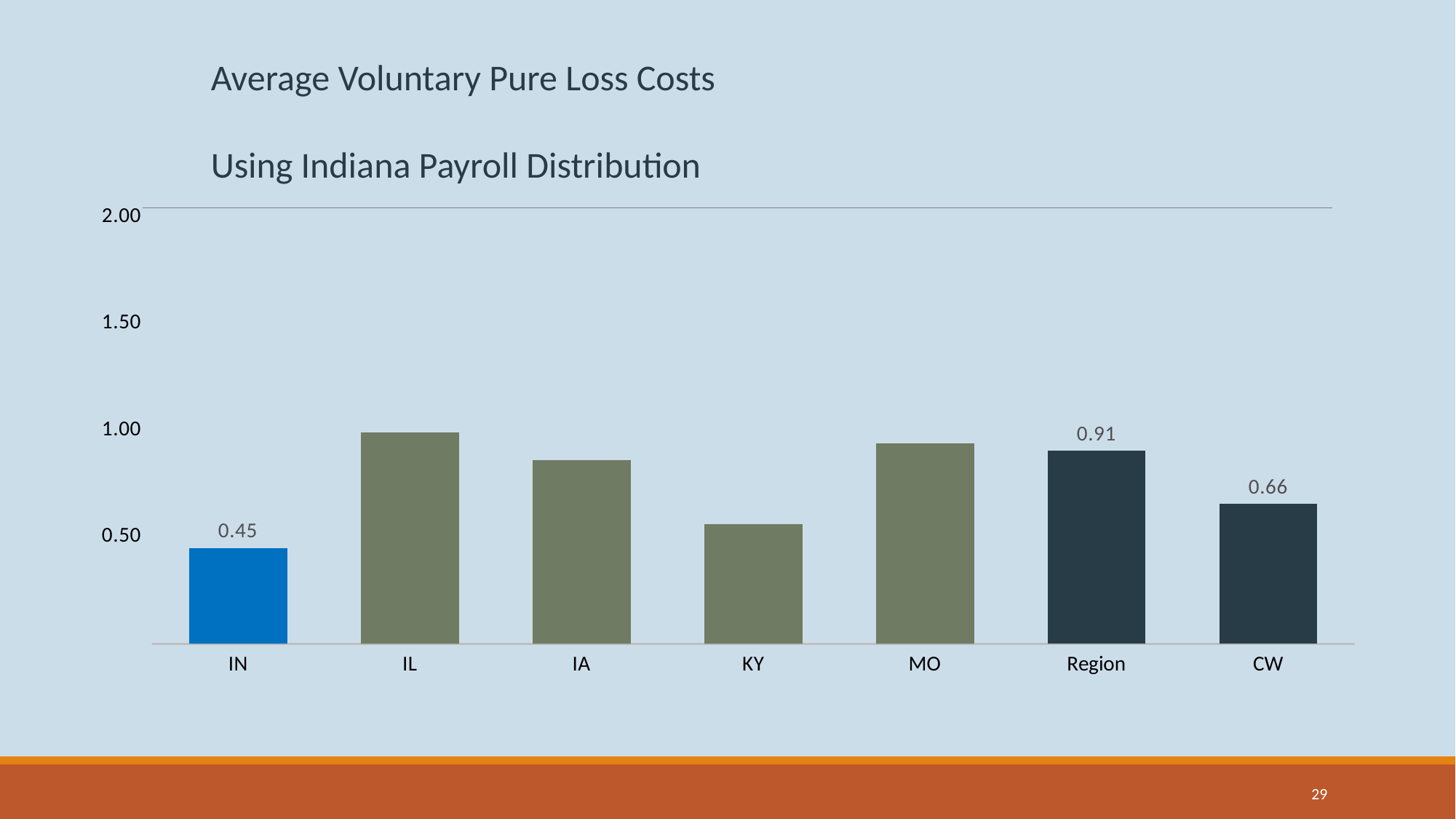
Is the value for IL greater or less than 0.50? greater How many categories are shown on the x axis? 7 What is the title of the chart? Average Voluntary Pure Loss Costs Using Indiana Payroll Distribution Which is larger, the value for KY or the value for IN? KY Is the value for MO greater or less than 1.00? less Which category has the lowest value? IN What is the difference between the values for Region and CW? 0.25 What is the difference between the values for Region and IN? 0.46 What is the value for Region? 0.91 What kind of chart is shown on the slide? bar chart What is the value for IN? 0.45 What is the value for CW? 0.66